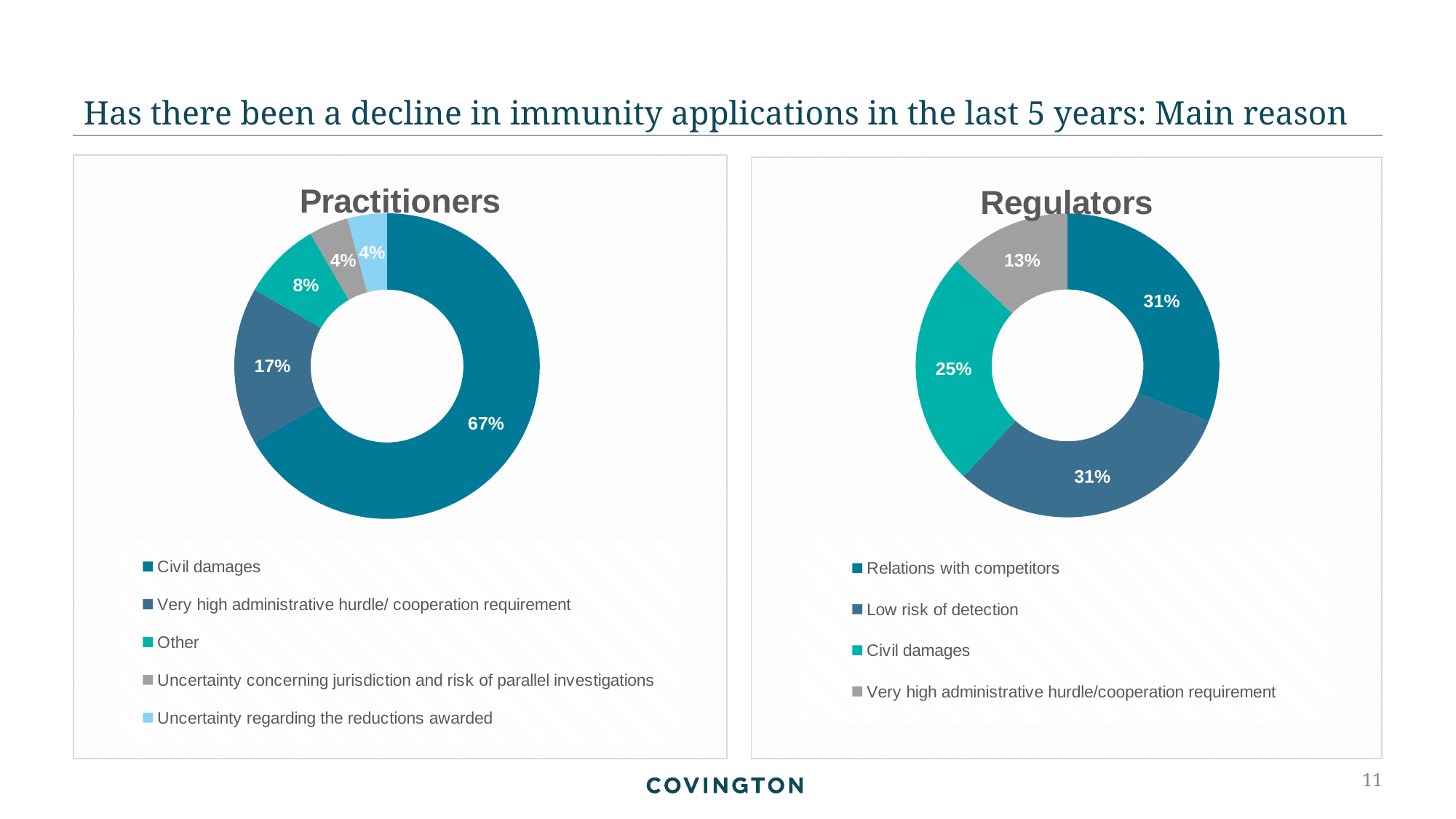
In the Practitioners chart, what share is labelled for Other? 8% In the Practitioners chart, which category has the largest share? Civil damages In the Practitioners chart, how many categories does the legend list? 5 In the Practitioners chart, what is the difference between the Civil damages share and the Very high administrative hurdle/ cooperation requirement share? 50 percentage points In the Regulators chart, which category has the smallest share? Very high administrative hurdle/cooperation requirement In the Practitioners chart, what share is labelled for Civil damages? 67% In the Practitioners chart, what share is labelled for Very high administrative hurdle/ cooperation requirement? 17% What type of chart is the Regulators chart? Doughnut (pie) chart In the Regulators chart, how many categories does the legend list? 4 In the Regulators chart, what share is labelled for Very high administrative hurdle/cooperation requirement? 13% In the Regulators chart, what share is labelled for Civil damages? 25% In the Regulators chart, what share is labelled for Relations with competitors? 31%